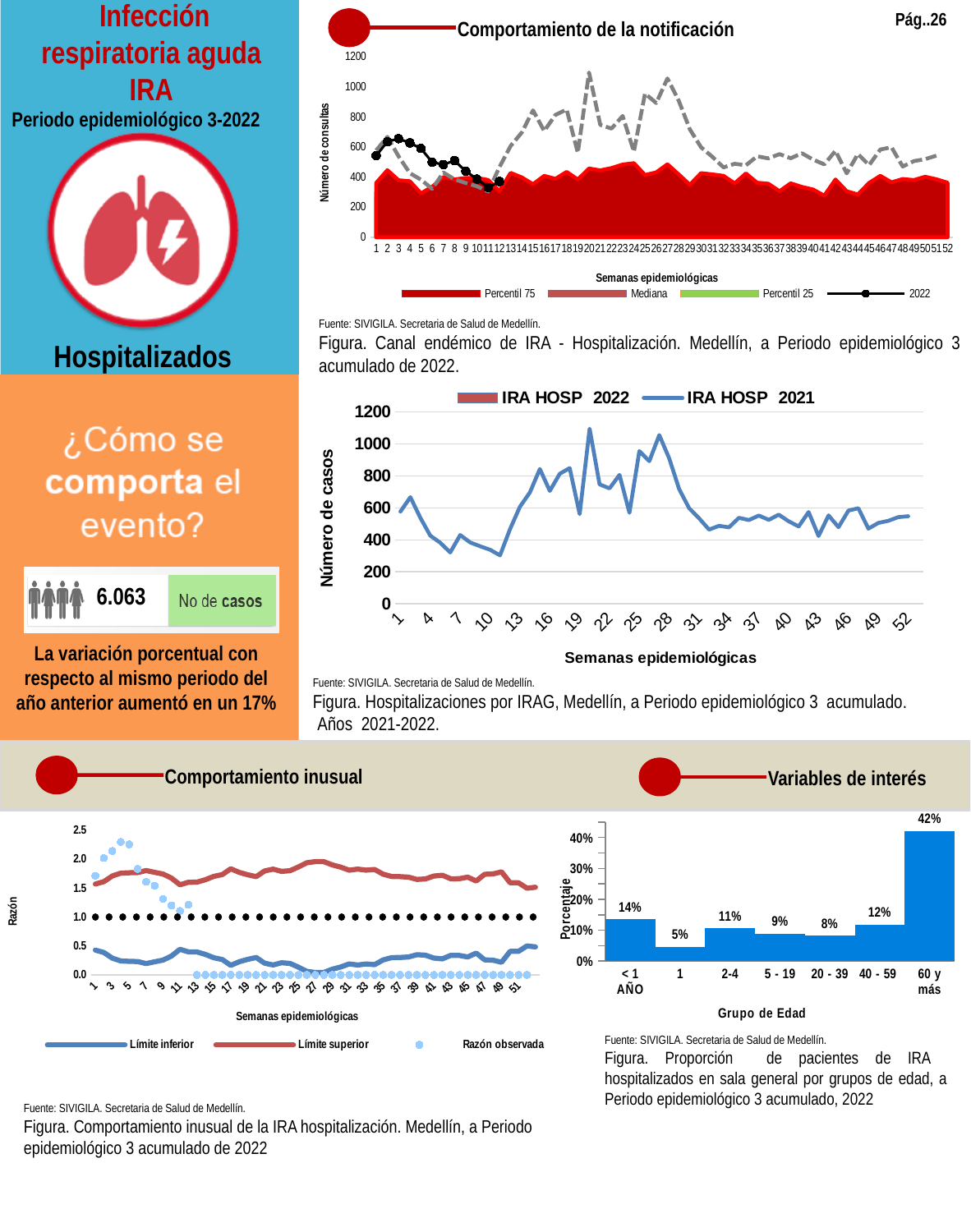
In the bar chart under 'Variables de interés', what is the percentage for the '< 1 AÑO' age group? 14% How many series does the legend list in the 'Comportamiento de la notificación' chart? 4 What kind of chart is shown under 'Variables de interés'? Bar chart What is the y-axis title of the 'IRA HOSP 2022 / IRA HOSP 2021' line chart? Número de casos In the bar chart under 'Variables de interés', which age group has a larger percentage, '2-4' or '5 - 19'? 2-4 In the bar chart under 'Variables de interés', what is the percentage for the '60 y más' age group? 42% In the 'IRA HOSP 2022 / IRA HOSP 2021' line chart, is the value for IRA HOSP 2021 at week 10 greater or less than 400? less How many age groups are shown in the bar chart under 'Variables de interés'? 7 In the bar chart under 'Variables de interés', which age group has the lowest percentage? 1 In the bar chart under 'Variables de interés', which age group has the highest percentage? 60 y más In the bar chart under 'Variables de interés', what is the difference between the percentages for '60 y más' and '< 1 AÑO'? 28% How many series does the legend list in the 'IRA HOSP 2022 / IRA HOSP 2021' line chart? 2